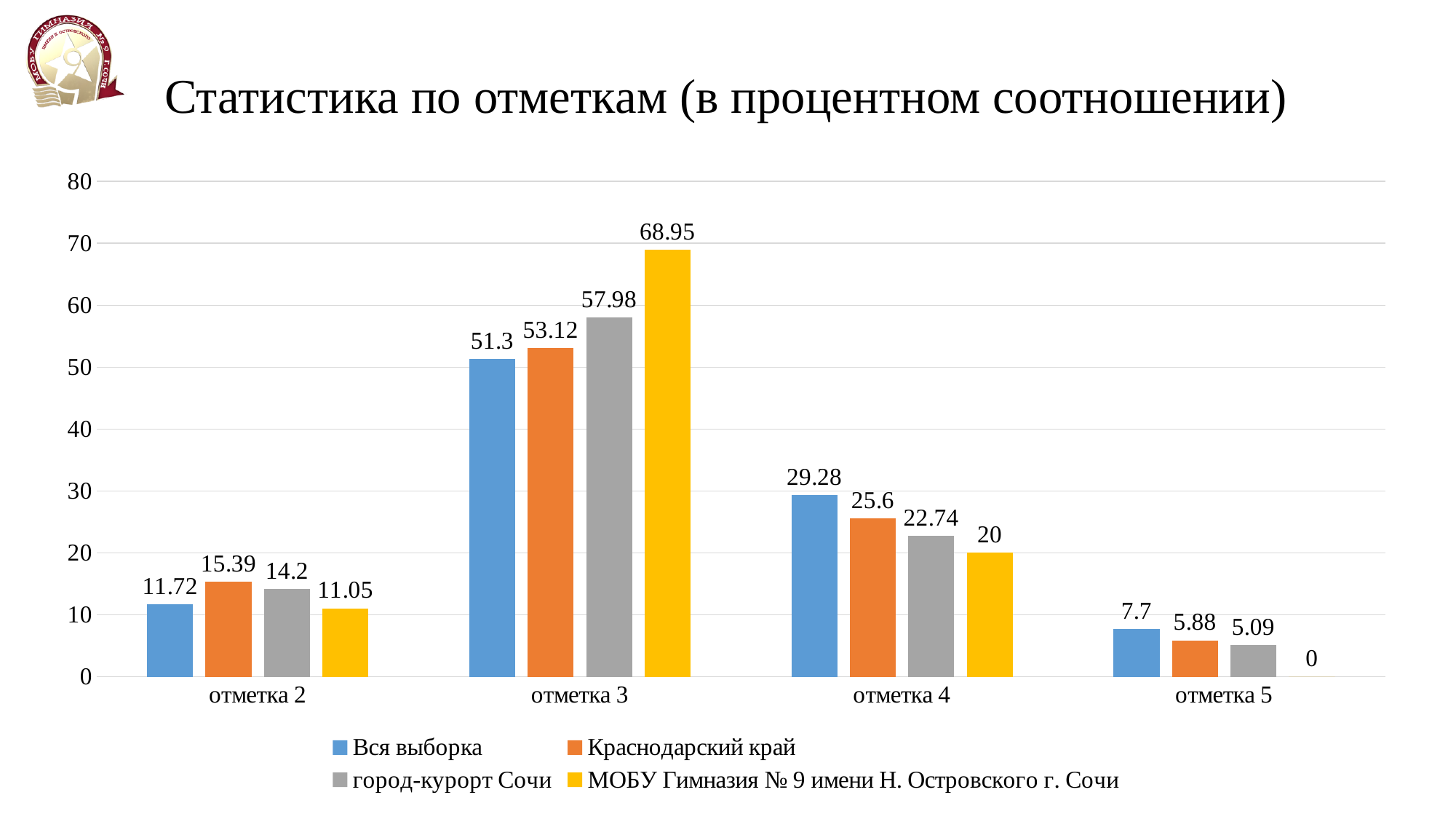
What kind of chart is shown on the slide? bar chart What is the difference between the МОБУ Гимназия № 9 value and the Вся выборка value at отметка 3? 17.65 What is the value for МОБУ Гимназия № 9 имени Н. Островского г. Сочи at отметка 3? 68.95 How many series does the legend list? 4 Which category has the highest value for Вся выборка? отметка 3 What is the value for Вся выборка at отметка 3? 51.3 How many categories are shown on the x axis? 4 What is the value for город-курорт Сочи at отметка 4? 22.74 At отметка 4, which is larger: Вся выборка or Краснодарский край? Вся выборка What is the value for Краснодарский край at отметка 5? 5.88 Which category has the lowest value for МОБУ Гимназия № 9 имени Н. Островского г. Сочи? отметка 5 What is the title of the slide? Статистика по отметкам (в процентном соотношении)